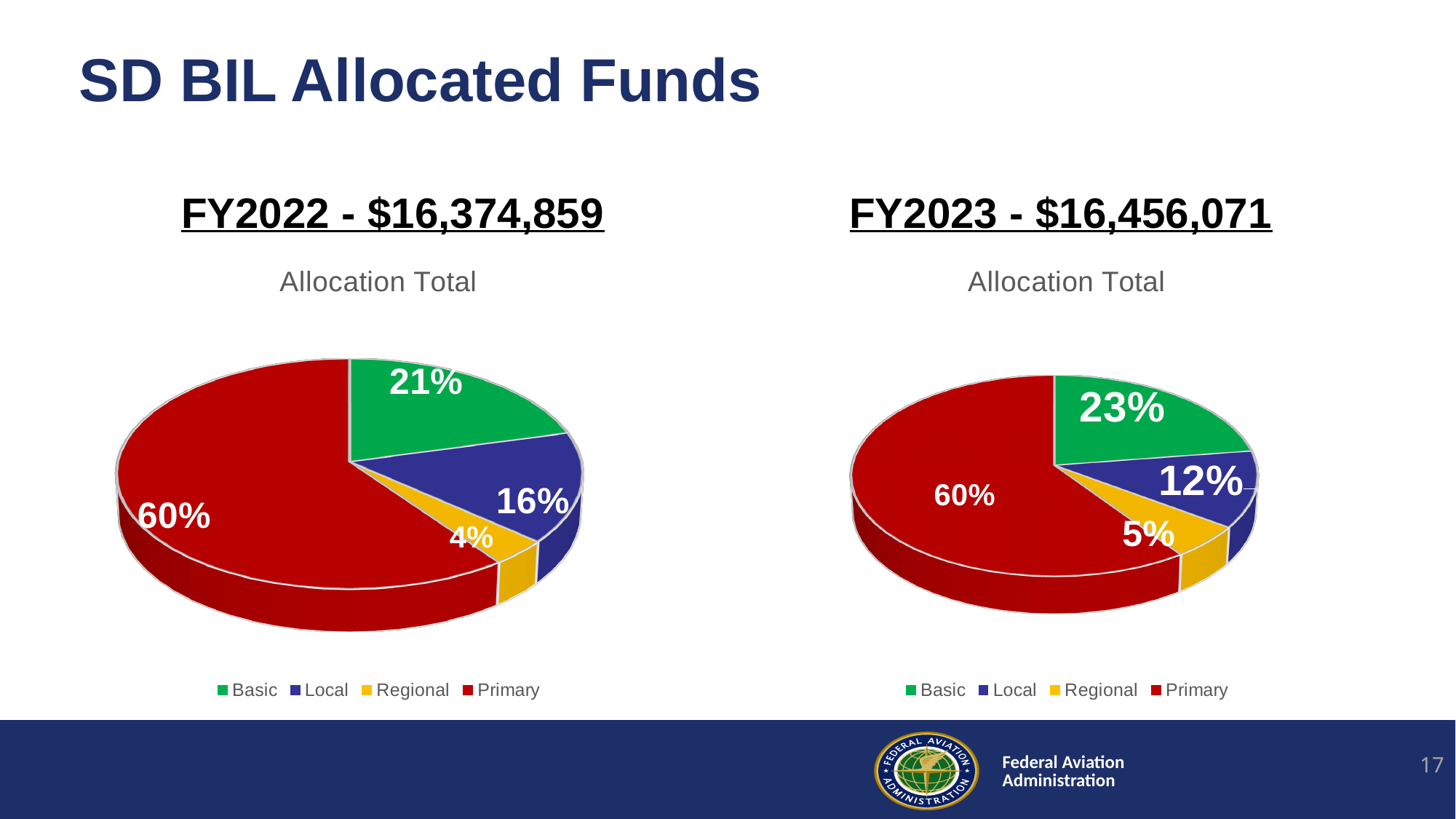
In the FY2022 pie chart, what share of the allocation total is Basic? 21% In the FY2022 pie chart, which category has the smallest share? Regional In the FY2023 pie chart, which category has the largest share? Primary How many categories does the FY2023 pie chart show? 4 In the FY2022 pie chart, what share of the allocation total is Regional? 4% In the FY2022 pie chart legend, which colour represents Regional? Yellow In the FY2023 pie chart, which is larger, the Basic share or the Local share? Basic In the FY2023 pie chart, what share of the allocation total is Local? 12% In the FY2022 pie chart, what share of the allocation total is Primary? 60% In the FY2023 pie chart, what share of the allocation total is Regional? 5% What type of chart is used for the FY2022 allocation total? Pie chart In the FY2022 pie chart, what is the difference in percentage points between the Basic and Local shares? 5